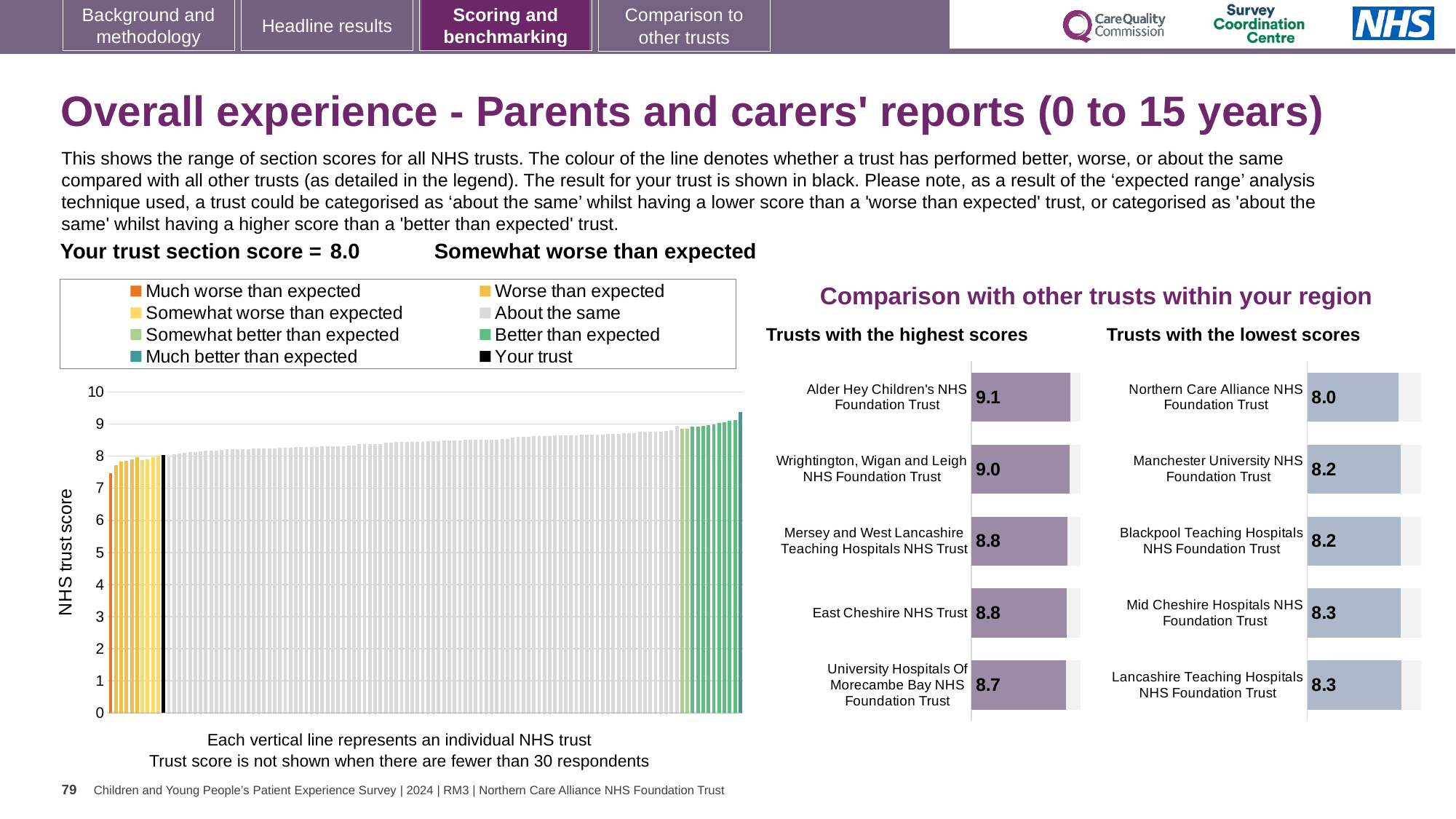
In the 'Trusts with the lowest scores' chart, what is the score for Northern Care Alliance NHS Foundation Trust? 8.0 In the 'Trusts with the lowest scores' chart, which has the larger score: Manchester University NHS Foundation Trust or Mid Cheshire Hospitals NHS Foundation Trust? Mid Cheshire Hospitals NHS Foundation Trust In the 'Trusts with the highest scores' chart, what is the score for Alder Hey Children's NHS Foundation Trust? 9.1 In the 'Trusts with the lowest scores' chart, what is the difference between the scores of Lancashire Teaching Hospitals NHS Foundation Trust and Northern Care Alliance NHS Foundation Trust? 0.3 In the 'Trusts with the highest scores' chart, what is the score for University Hospitals Of Morecambe Bay NHS Foundation Trust? 8.7 How many trusts are shown in the 'Trusts with the highest scores' chart? 5 In the 'Trusts with the lowest scores' chart, which trust has the lowest score? Northern Care Alliance NHS Foundation Trust What kind of chart is the large chart on the left with the y-axis labelled 'NHS trust score'? Bar chart In the 'Trusts with the highest scores' chart, what is the difference between the scores of Alder Hey Children's NHS Foundation Trust and University Hospitals Of Morecambe Bay NHS Foundation Trust? 0.4 How many entries does the legend above the large chart on the left list? 8 In the 'Trusts with the highest scores' chart, which trust has the highest score? Alder Hey Children's NHS Foundation Trust In the large chart on the left, do the trust scores rise or fall from left to right? Rise